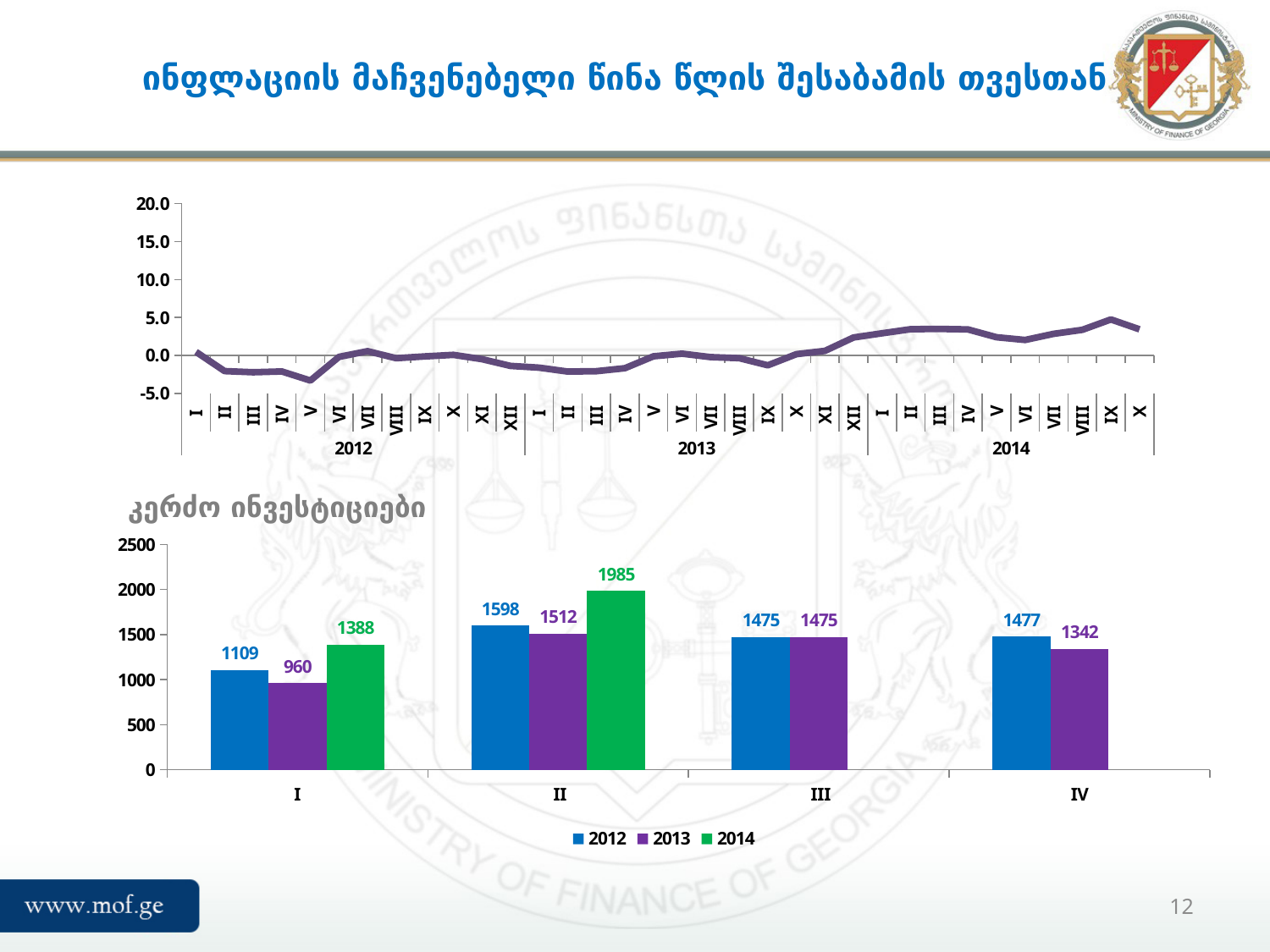
In the bottom bar chart, what is the value for 2012 in quarter IV? 1477 In the bottom bar chart, which quarter has the lowest value for the 2013 series? I In the top line chart, is the value for V 2012 greater or less than 0.0? less In the bottom bar chart, what is the difference between the 2012 and 2013 values in quarter IV? 135 In the top line chart, is the value for IX 2014 greater or less than 0.0? greater In the bottom bar chart, what is the value for 2013 in quarter I? 960 How many series does the legend of the bottom bar chart list? 3 In the bottom bar chart, which quarter has the highest value for the 2014 series? II What kind of chart is the top chart on the slide? line chart In the bottom bar chart, what is the difference between the 2014 and 2013 values in quarter II? 473 In the bottom bar chart, what is the value for 2014 in quarter II? 1985 In the bottom bar chart, which is larger in quarter I: the 2012 value or the 2014 value? 2014